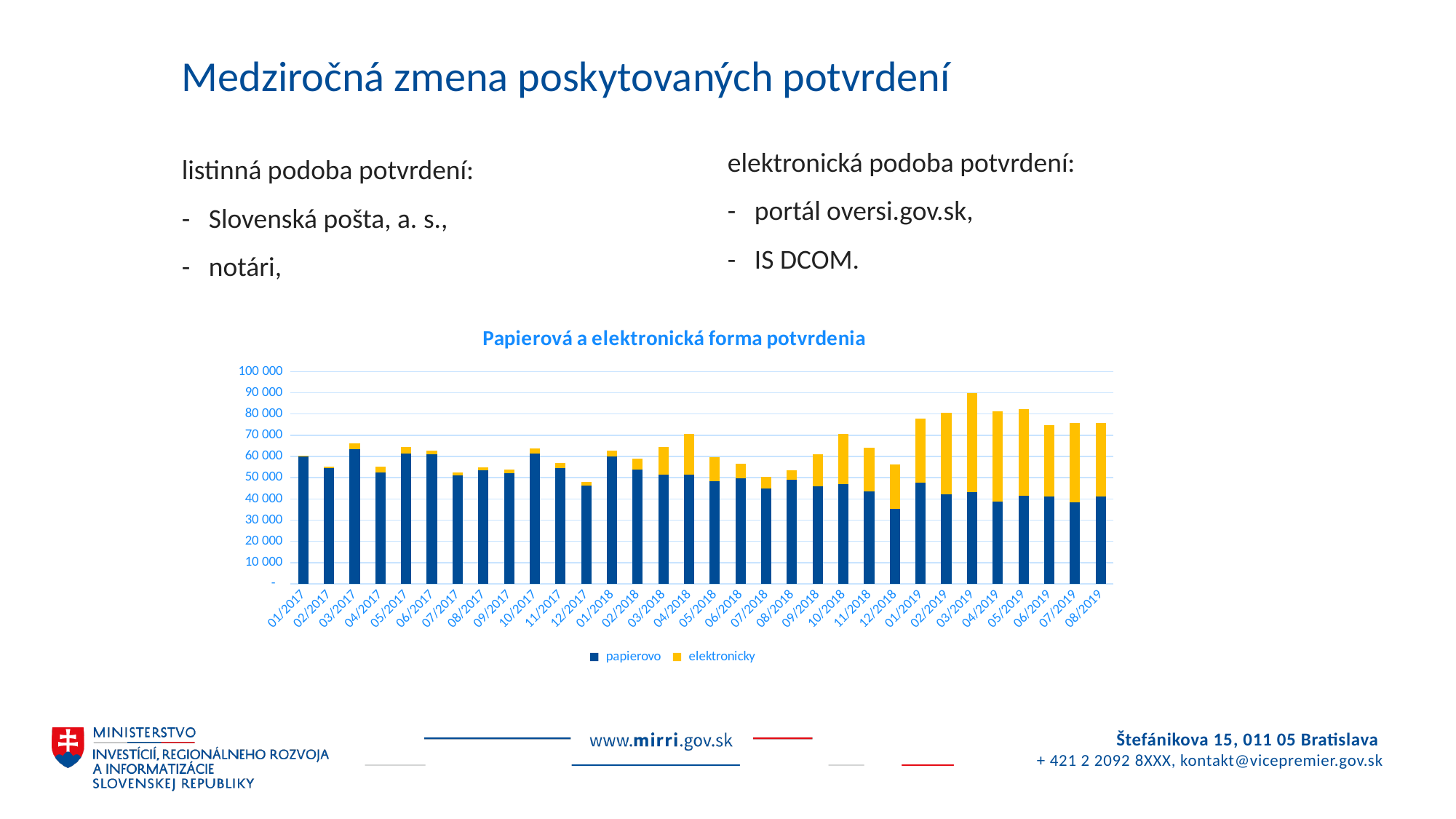
What are the two series named in the legend? papierovo, elektronicky Does the papierovo series generally rise or fall from 01/2017 to 08/2019? fall Which month has the highest total stacked bar? 03/2019 What kind of chart is shown on the slide? bar chart Does the elektronicky series generally rise or fall from 01/2017 to 08/2019? rise Is the total value for 12/2017 greater or less than 50 000? less How many months (categories) are shown on the x axis? 32 How many series does the chart legend list? 2 Is the papierovo value for 12/2018 greater or less than 40 000? less Which is larger, the papierovo value for 01/2017 or for 08/2019? 01/2017 What is the title of the chart? Papierová a elektronická forma potvrdenia Is the total value for 03/2019 greater or less than 80 000? greater